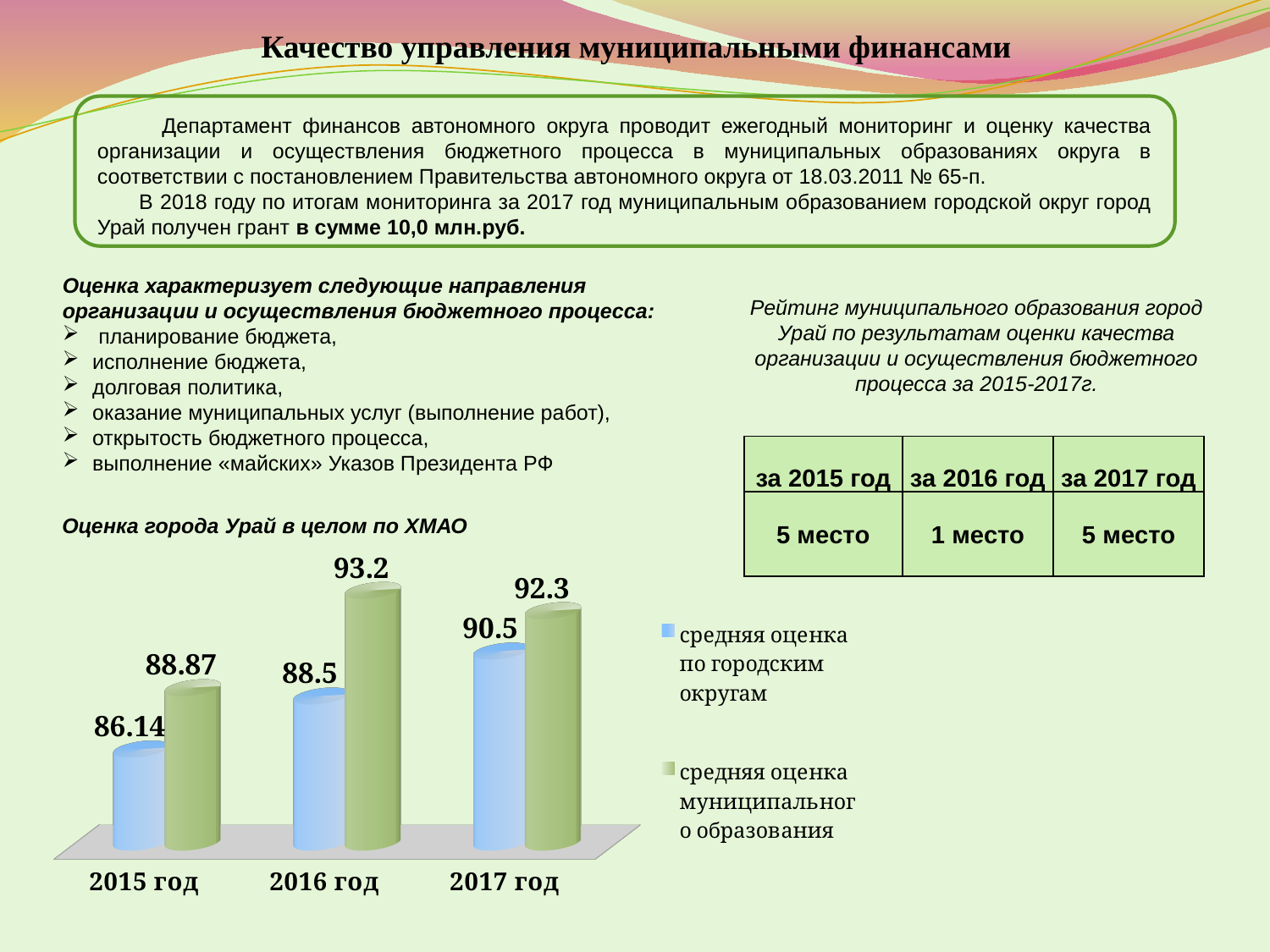
Какое значение средней оценки муниципального образования показано на диаграмме за 2016 год? 93.2 Какого типа диаграмма на слайде? столбчатая (bar chart) Сколько рядов данных указано в легенде диаграммы? 2 В каком году средняя оценка по городским округам была наименьшей? 2015 год Как изменяется средняя оценка по городским округам с 2015 по 2017 год? растёт Какая оценка выше за 2017 год: средняя по городским округам или средняя муниципального образования? средняя оценка муниципального образования На сколько средняя оценка муниципального образования превышает среднюю оценку по городским округам в 2016 году? 4.7 Какое значение средней оценки по городским округам показано за 2017 год? 90.5 В каком году средняя оценка муниципального образования была наибольшей? 2016 год Как называется диаграмма на слайде? Оценка города Урай в целом по ХМАО Сколько лет (категорий) показано на диаграмме? 3 Какое значение средней оценки по городским округам показано на диаграмме за 2015 год? 86.14